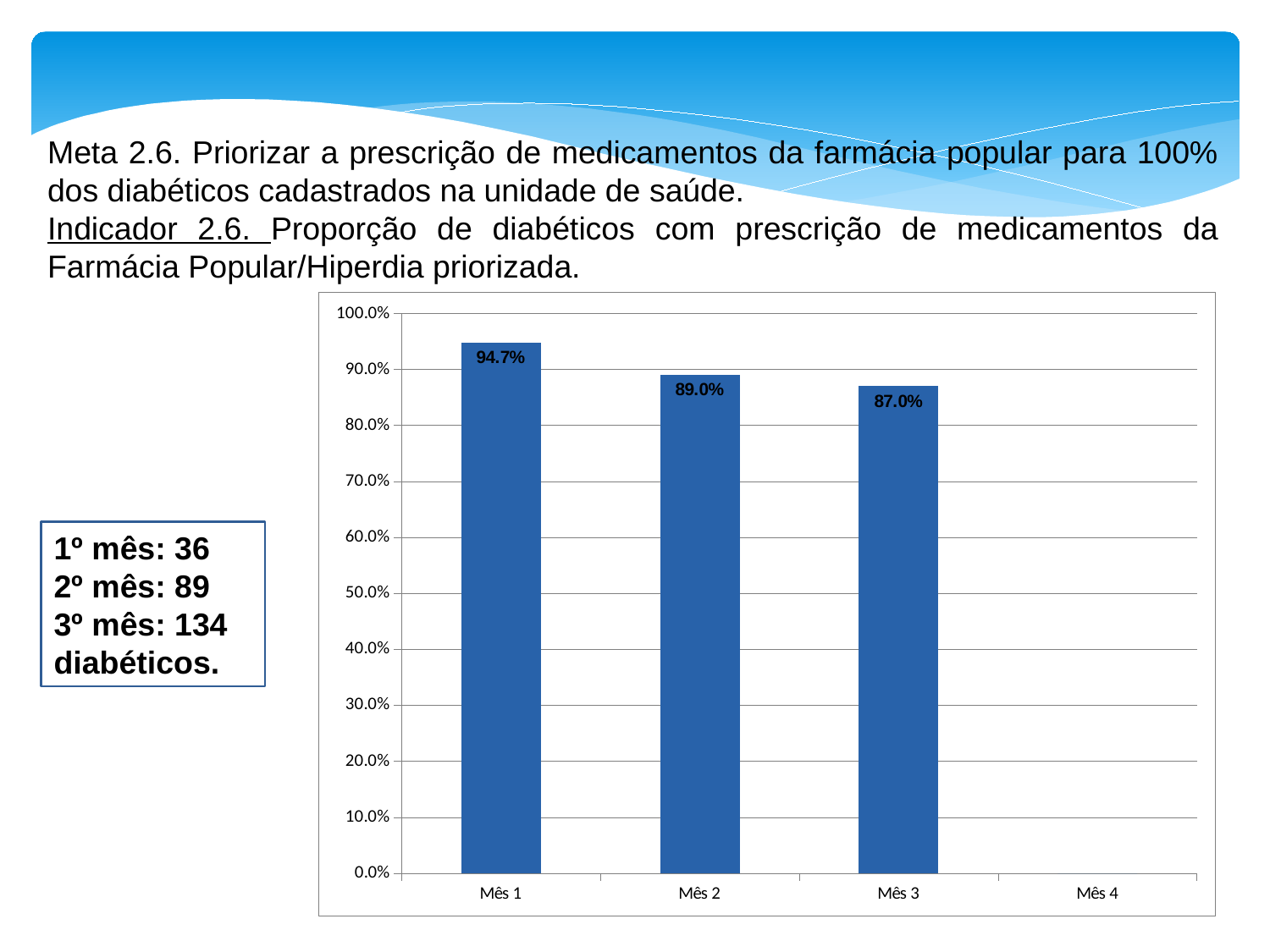
What is the difference between the values for Mês 1 and Mês 3? 7.7% What is the difference between the values for Mês 1 and Mês 2? 5.7% What is the value for Mês 2? 89.0% How many categories are shown on the x axis? 4 Which is larger, the value for Mês 2 or the value for Mês 3? Mês 2 What is the value for Mês 1? 94.7% Is the value for Mês 1 greater or less than 90.0%? greater What kind of chart is shown on the slide? bar chart Do the values rise or fall from Mês 1 to Mês 3? fall What is the value for Mês 3? 87.0% Which month has the highest value? Mês 1 Which month with a plotted bar has the lowest value? Mês 3